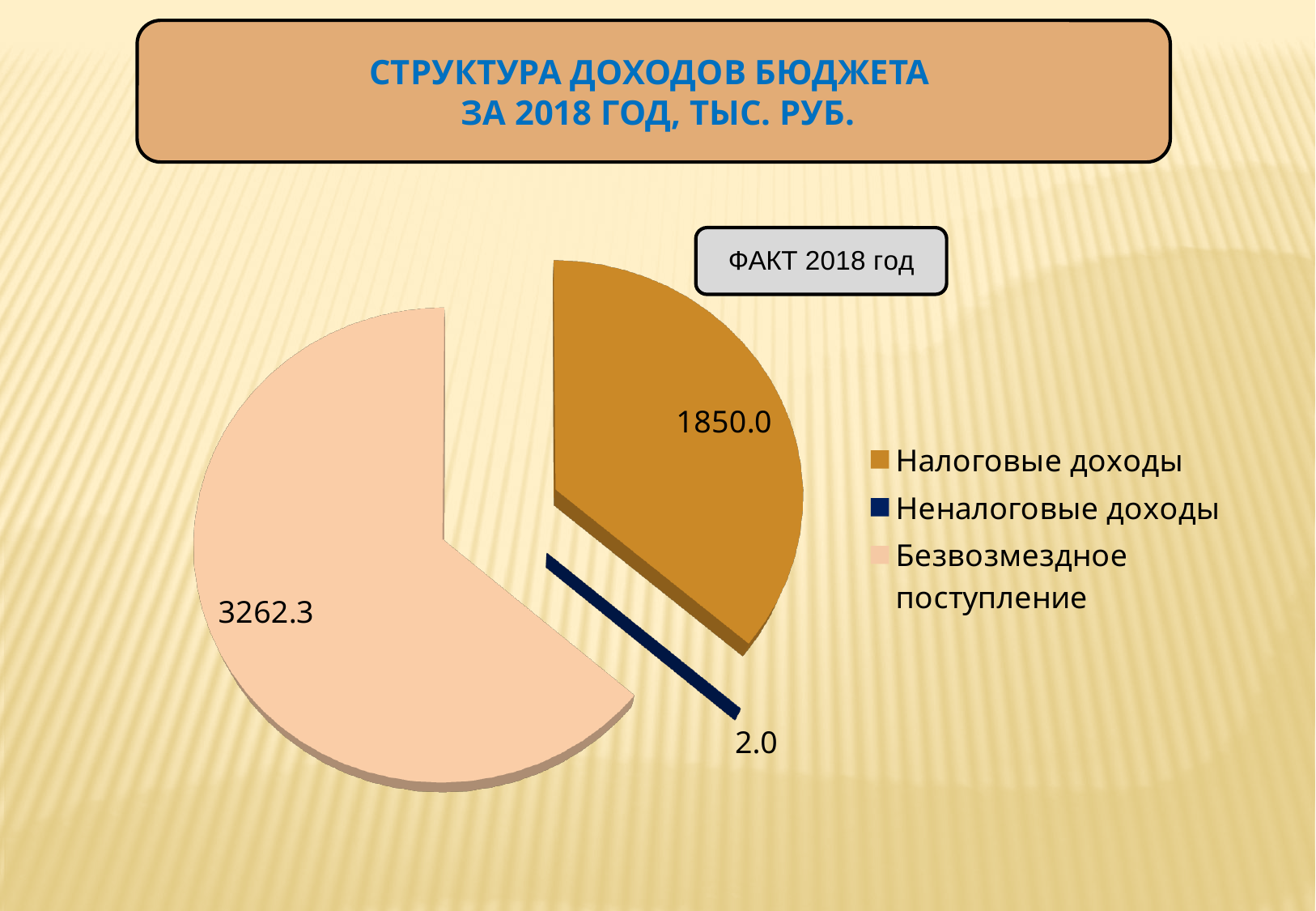
What is the total of all slices in the pie chart? 5114.3 Which category has the largest value? Безвозмездное поступление What is the value for Неналоговые доходы? 2.0 How many entries does the legend list? 3 What is the difference between Безвозмездное поступление and Налоговые доходы? 1412.3 How many slices does the pie chart have? 3 What is the value for Безвозмездное поступление? 3262.3 Which is larger, Налоговые доходы or Неналоговые доходы? Налоговые доходы Which category has the smallest value? Неналоговые доходы What is the value for Налоговые доходы? 1850.0 What type of chart is shown on the slide? pie chart What is the title of the chart? СТРУКТУРА ДОХОДОВ БЮДЖЕТА ЗА 2018 ГОД, ТЫС. РУБ.